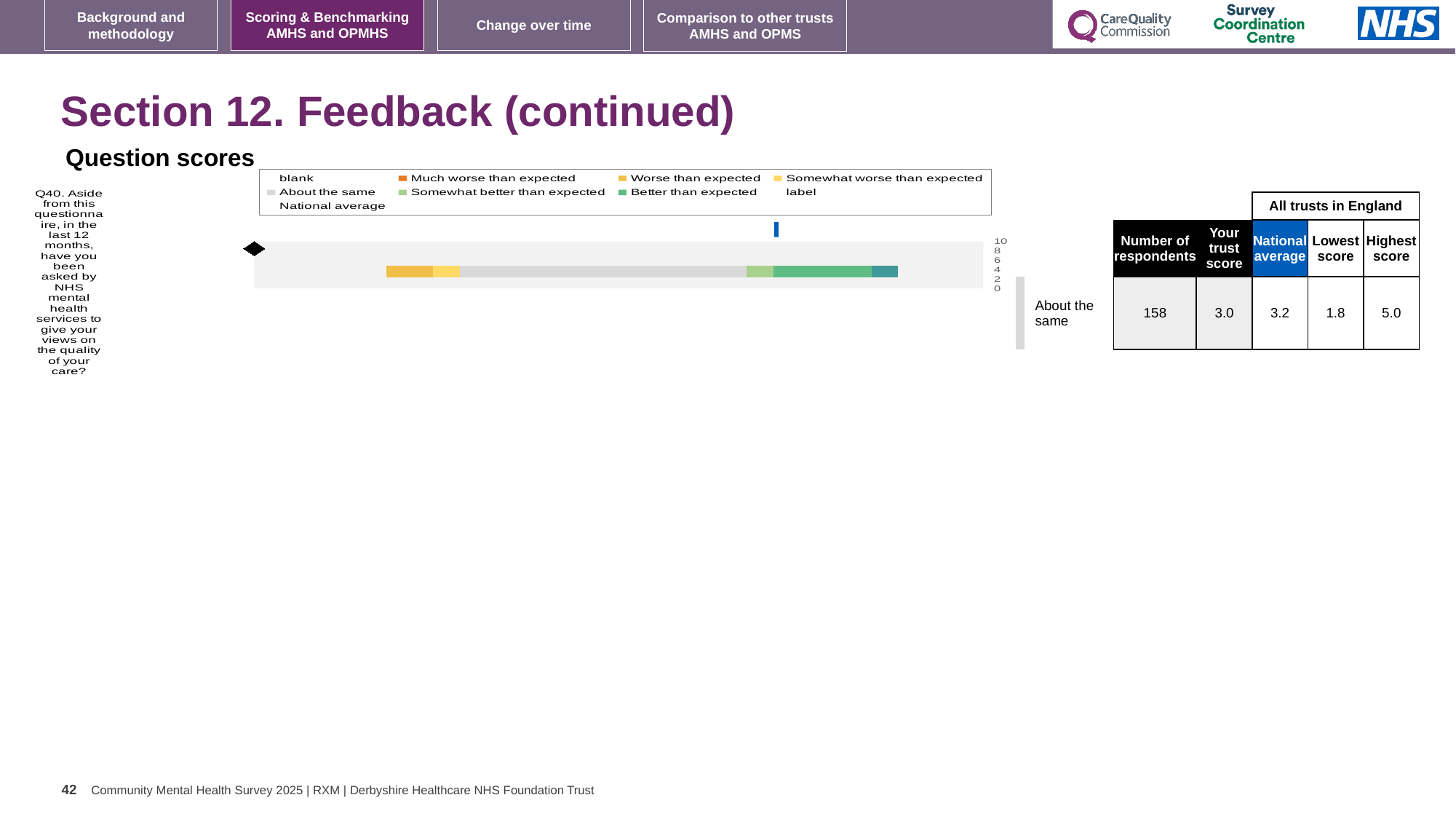
Which is larger for Q40: your trust score or the national average? national average What kind of chart is shown under 'Question scores'? bar chart In the table next to the chart, what is 'Your trust score' for Q40? 3.0 In the table next to the chart, what is the national average for Q40? 3.2 In the table next to the chart, what is the lowest score among all trusts in England for Q40? 1.8 Which question number is plotted in the chart? Q40 In the table next to the chart, what is the highest score among all trusts in England for Q40? 5.0 How many question categories are plotted in the chart? 1 In the table next to the chart, what is the number of respondents for Q40? 158 What benchmark category label is shown beside the Q40 bar? About the same What is the difference between the highest score and the lowest score for Q40 in the table? 3.2 Which legend entry is shown in orange in the chart? Much worse than expected